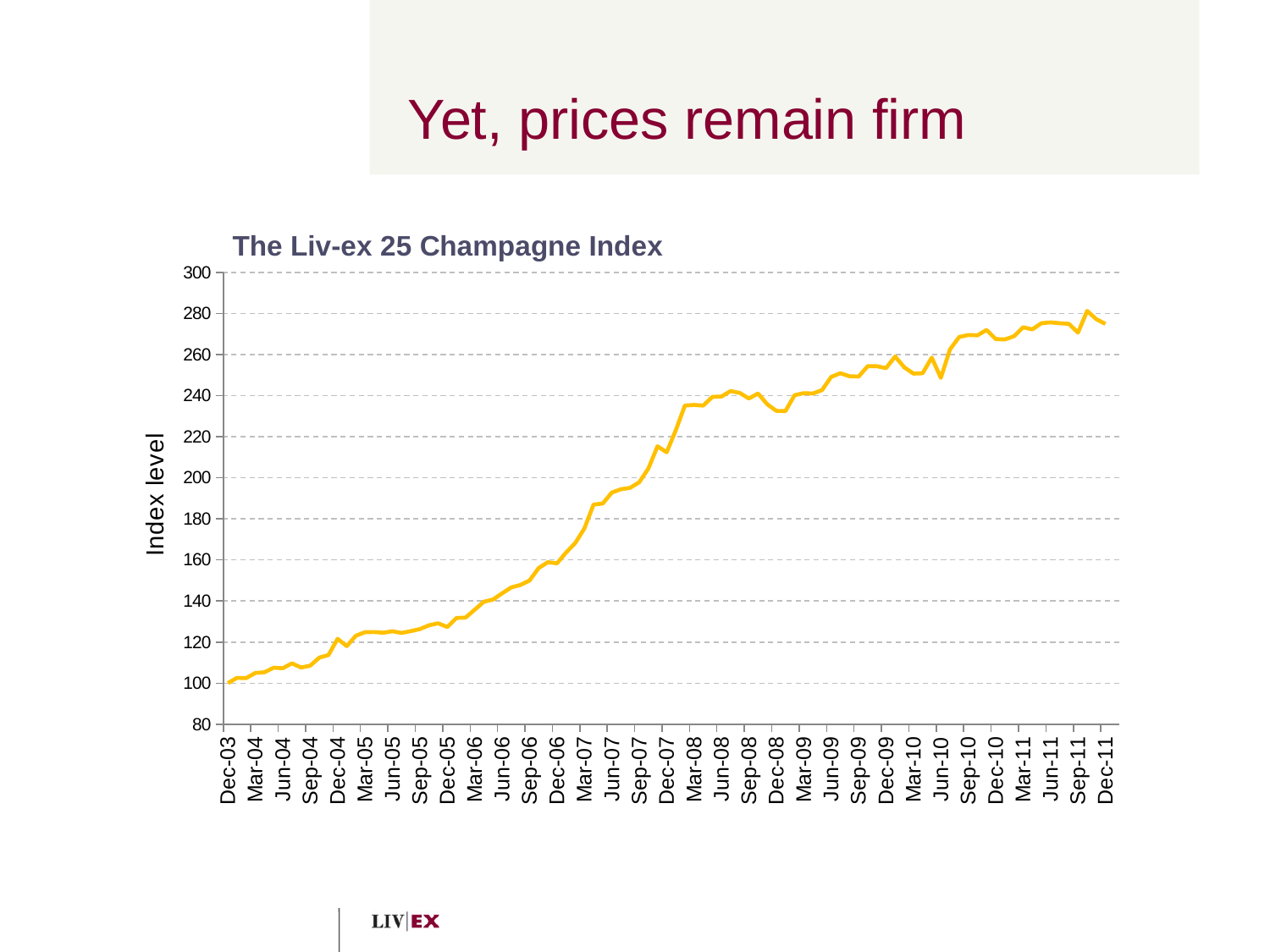
Does the index level generally rise or fall from Dec-03 to Dec-11? rise Is the value for Dec-05 greater or less than 140? less Is the value for Dec-07 greater or less than 200? greater What kind of chart is shown on the slide? line chart Is the value for Dec-11 greater or less than 260? greater How many lines are plotted on the chart? 1 At which date on the x axis is the index level lowest? Dec-03 What is the label on the vertical axis of the chart? Index level What is the title of the chart? The Liv-ex 25 Champagne Index Which is larger, the index level at Jun-06 or at Jun-07? Jun-07 What is the index level at Dec-03, the first point on the chart? 100